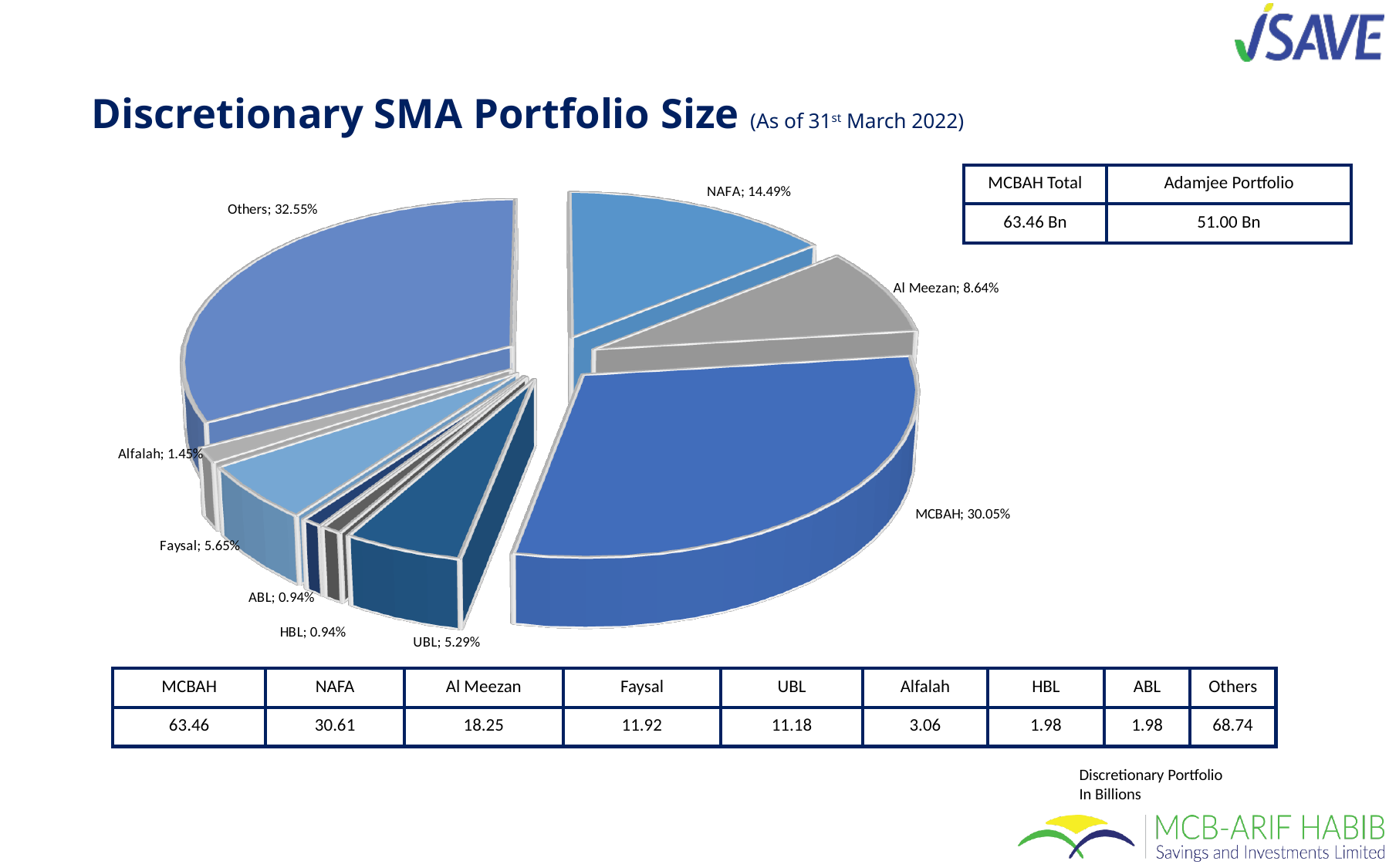
What percentage is shown for NAFA? 14.49% What share of the pie does MCBAH hold? 30.05% What is the share for Alfalah? 1.45% How many slices does the pie chart have? 9 What is the value labelled for Al Meezan? 8.64% Which slice has the largest share of the pie? Others What percentage does the Faysal slice show? 5.65% What is the difference between the Others share and the MCBAH share? 2.50% Which is larger, the UBL slice or the Faysal slice? Faysal What is the title of the slide containing the chart? Discretionary SMA Portfolio Size What kind of chart is shown on the slide? Pie chart Which is larger, the NAFA slice or the Al Meezan slice? NAFA